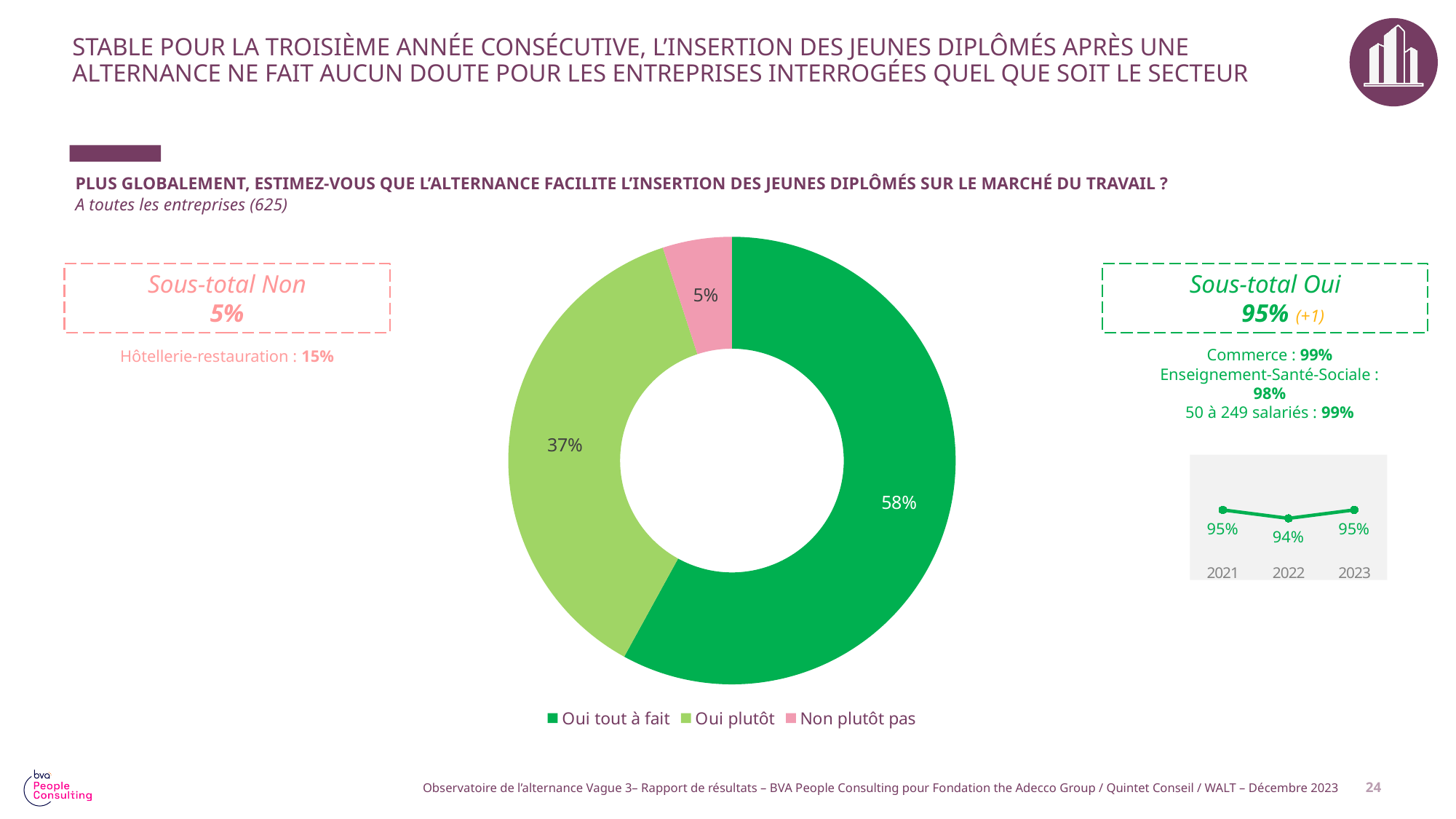
On the donut chart, what share of companies answered "Oui tout à fait"? 58% On the donut chart, which is larger: the share for "Oui plutôt" or the share for "Non plutôt pas"? Oui plutôt On the donut chart, which response category has the largest share? Oui tout à fait What type of chart is the large chart in the centre of the slide? Donut (pie) chart On the donut chart, which response category has the smallest share? Non plutôt pas On the small line chart at the right of the slide, what is the difference in percentage points between 2023 and 2022? 1 How many categories does the legend of the donut chart list? 3 On the donut chart, what share of companies answered "Oui plutôt"? 37% On the small line chart at the right of the slide, what is the value for 2022? 94% On the donut chart, what share of companies answered "Non plutôt pas"? 5% On the small line chart at the right of the slide, how many years are plotted? 3 On the donut chart, what is the difference in percentage points between "Oui tout à fait" and "Oui plutôt"? 21